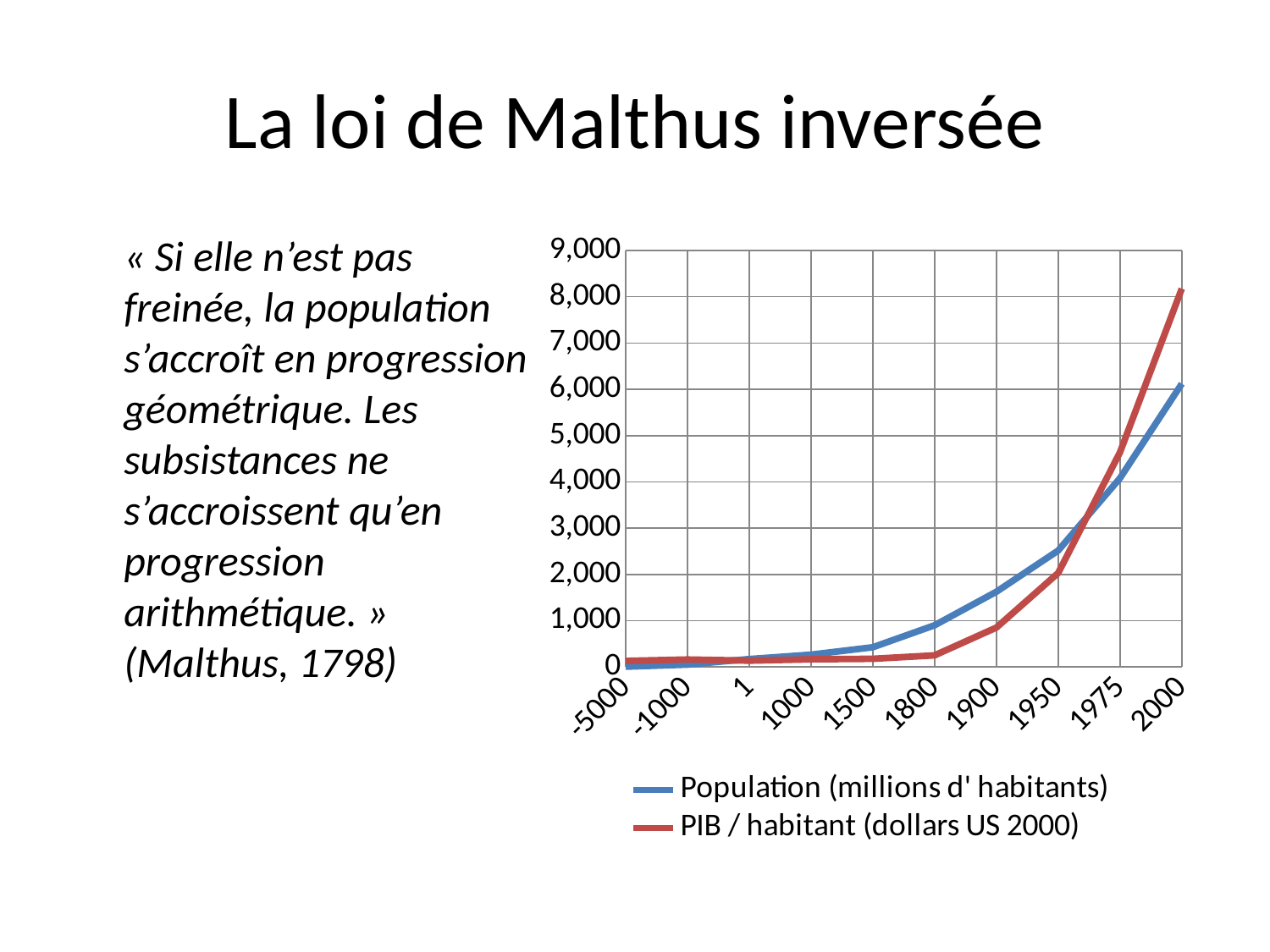
Is the value of Population (millions d' habitants) at 1950 greater or less than 2,000? greater Is the value of PIB / habitant (dollars US 2000) at 2000 greater or less than 7,000? greater Do the values of PIB / habitant (dollars US 2000) rise or fall from 1800 to 2000? rise Is the value of PIB / habitant (dollars US 2000) at 1900 greater or less than 1,000? less At 1950, which series has the higher value, Population (millions d' habitants) or PIB / habitant (dollars US 2000)? Population (millions d' habitants) How many series does the chart legend list? 2 At 2000, which series has the higher value, Population (millions d' habitants) or PIB / habitant (dollars US 2000)? PIB / habitant (dollars US 2000) Which series is shown in red in the chart? PIB / habitant (dollars US 2000) What kind of chart is shown on the slide? line chart How many points are plotted along the x axis for each series? 10 Which series is shown in blue in the chart? Population (millions d' habitants)